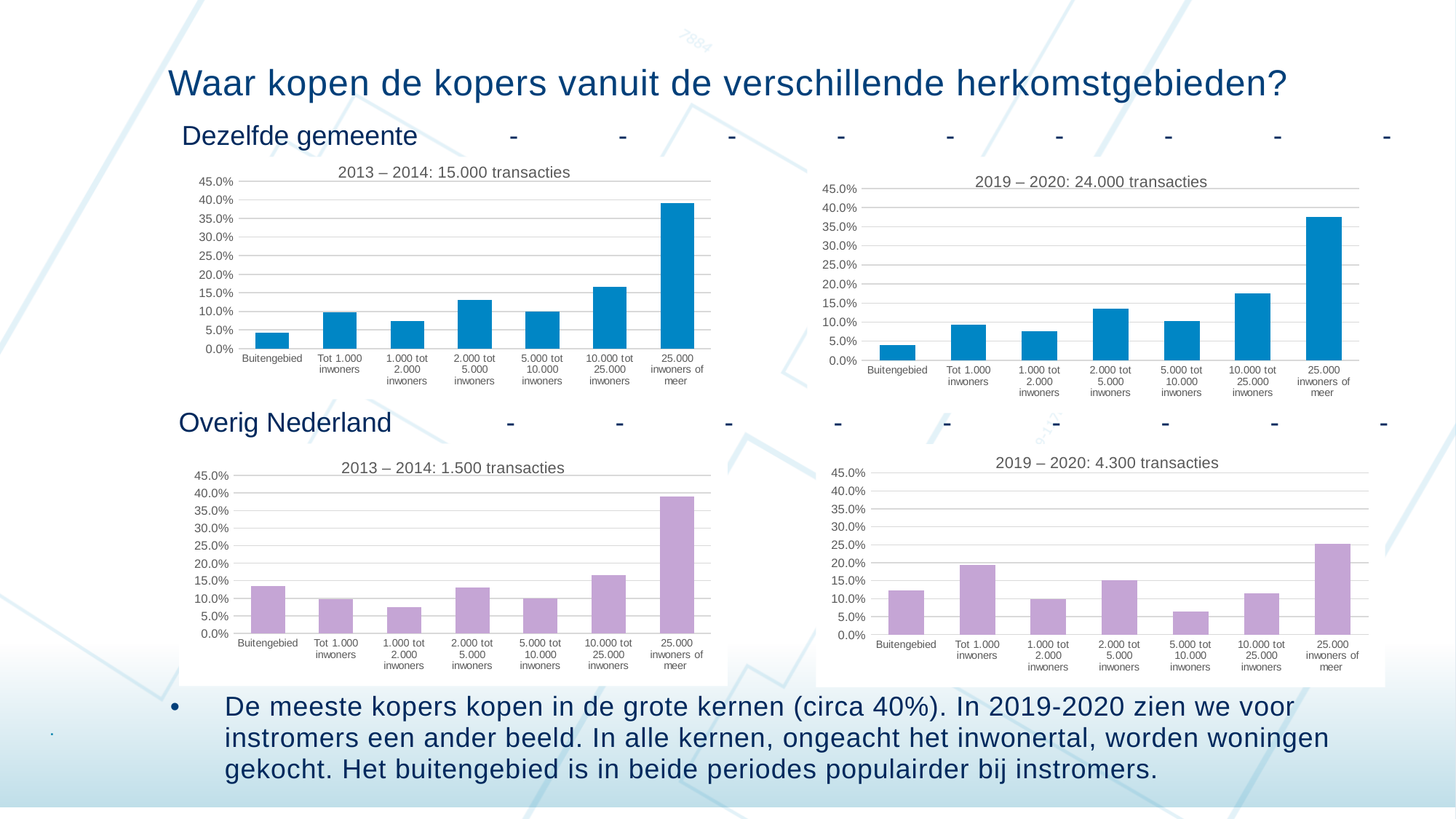
In the bottom-right chart titled '2019 – 2020: 4.300 transacties', which category has the highest value? 25.000 inwoners of meer In the bottom-right chart titled '2019 – 2020: 4.300 transacties', which category has the lowest value? 5.000 tot 10.000 inwoners How many categories are shown on the x axis of the top-right chart titled '2019 – 2020: 24.000 transacties'? 7 In the top-left chart titled '2013 – 2014: 15.000 transacties', which category has the highest value? 25.000 inwoners of meer What kind of chart is the bottom-left chart titled '2013 – 2014: 1.500 transacties'? bar chart In the bottom-right chart titled '2019 – 2020: 4.300 transacties', which is larger: the value for 'Tot 1.000 inwoners' or for 'Buitengebied'? Tot 1.000 inwoners What is the title of the top-right chart on the slide? 2019 – 2020: 24.000 transacties In the top-left chart titled '2013 – 2014: 15.000 transacties', is the value for '25.000 inwoners of meer' greater or less than 35.0%? greater In the top-right chart titled '2019 – 2020: 24.000 transacties', is the value for 'Buitengebied' greater or less than 5.0%? less In the top-right chart titled '2019 – 2020: 24.000 transacties', is the value for '10.000 tot 25.000 inwoners' greater or less than 15.0%? greater In the bottom-left chart titled '2013 – 2014: 1.500 transacties', which is larger: the value for 'Buitengebied' or for 'Tot 1.000 inwoners'? Buitengebied In the top-left chart titled '2013 – 2014: 15.000 transacties', which category has the lowest value? Buitengebied